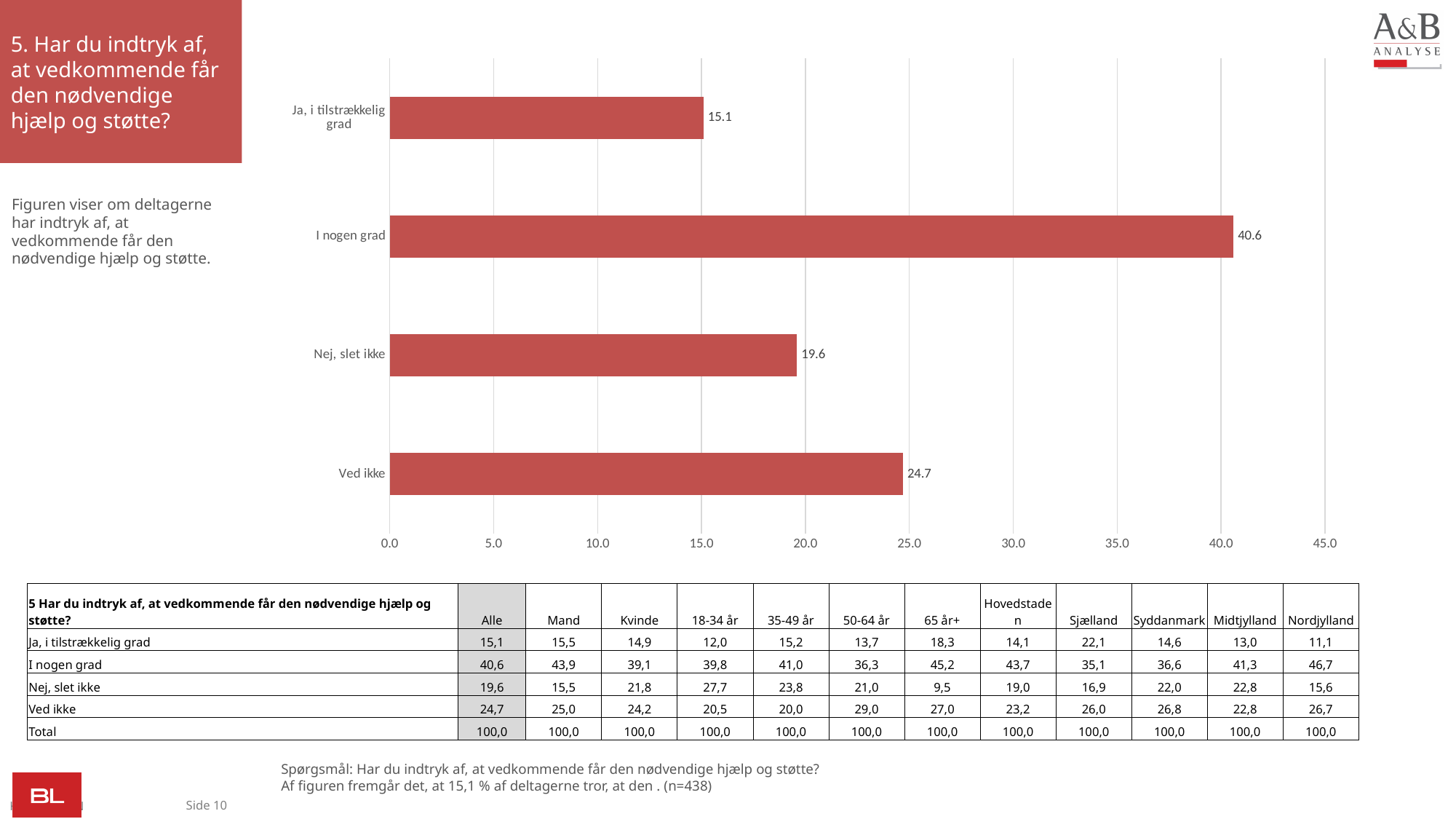
What is the value for "Ved ikke"? 24.7 What is the highest tick value shown on the horizontal axis? 45.0 Which is larger, the value for "Nej, slet ikke" or the value for "Ved ikke"? Ved ikke What kind of chart is shown on the slide? bar chart How many categories are shown in the chart? 4 What is the value for "Ja, i tilstrækkelig grad"? 15.1 What is the difference between the values for "I nogen grad" and "Ved ikke"? 15.9 Which category has the highest value? I nogen grad Which category has the lowest value? Ja, i tilstrækkelig grad What is the value for "Nej, slet ikke"? 19.6 Is the value for "I nogen grad" greater or less than 35.0? greater What is the value for "I nogen grad"? 40.6